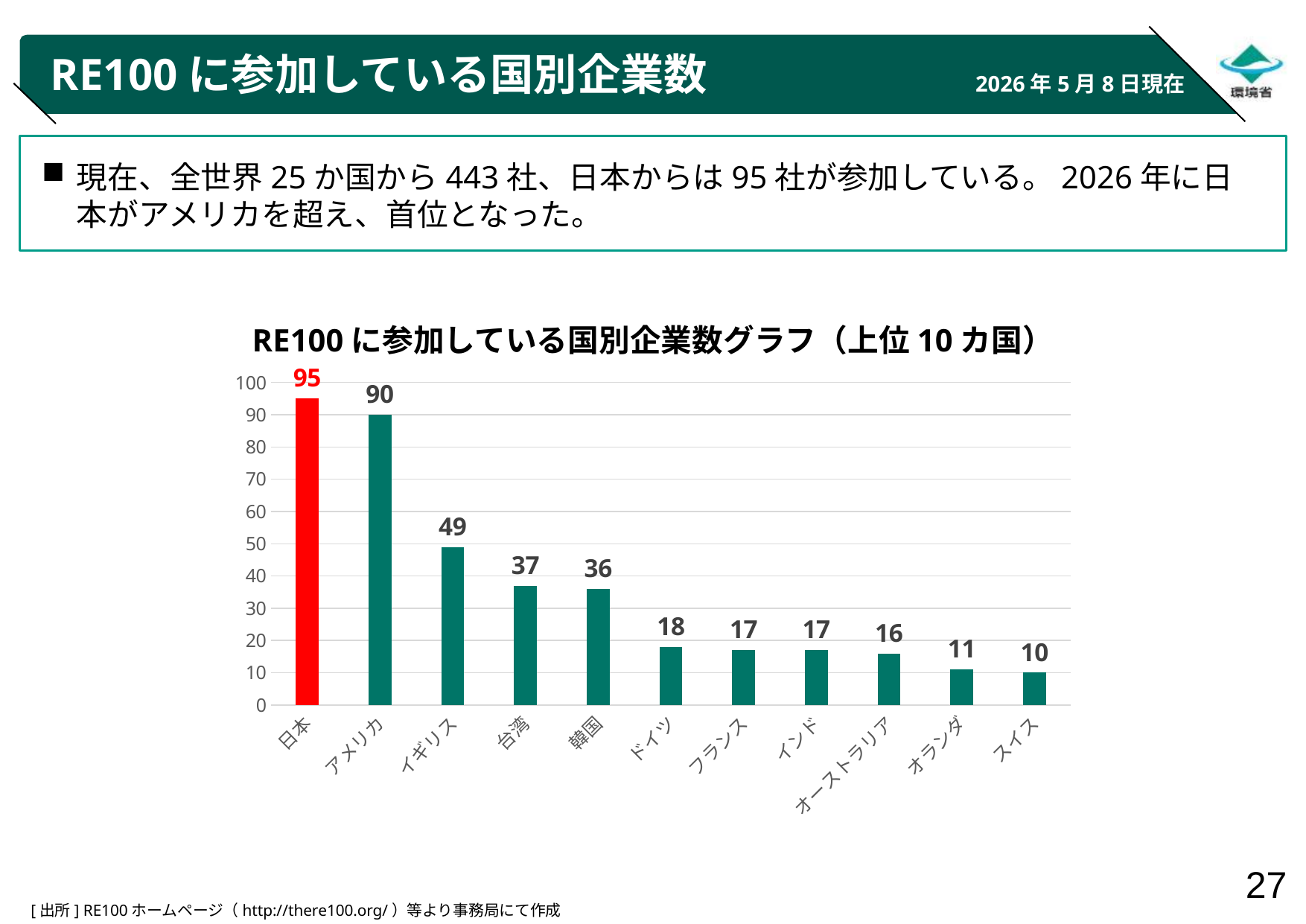
What is the value for 日本 in the chart? 95 What kind of chart is shown on the slide? Bar chart What is the value for オーストラリア in the chart? 16 Which country has the lowest value in the chart? スイス Which is larger, the value for 台湾 or the value for 韓国? 台湾 What is the difference between the values for 日本 and アメリカ? 5 Which country has the highest value in the chart? 日本 What is the difference between the values for イギリス and 台湾? 12 Which bar in the chart is coloured red? 日本 What is the value for アメリカ in the chart? 90 What is the value for イギリス in the chart? 49 How many countries are shown in the chart? 11